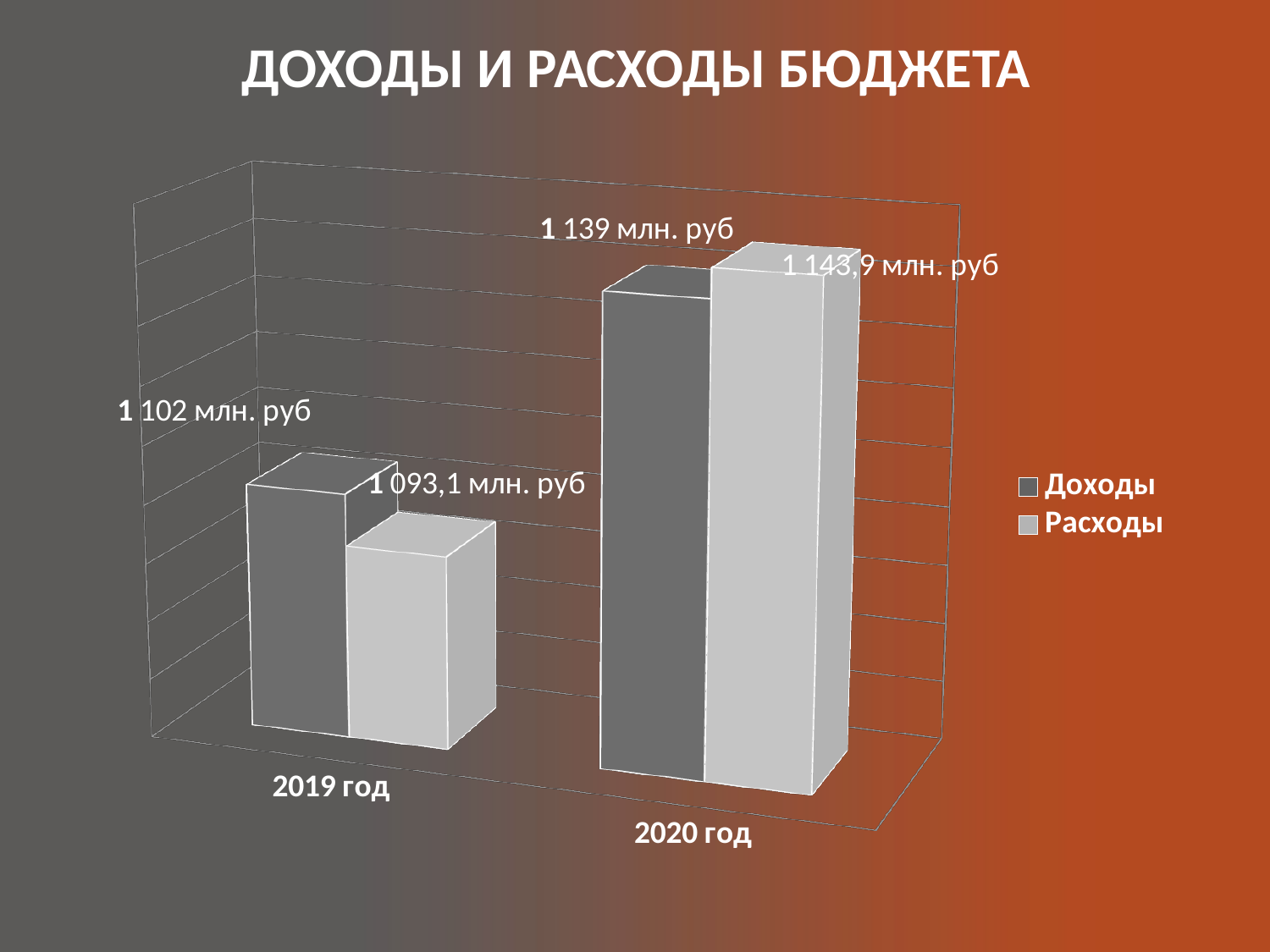
How many series does the legend list? 2 Which bar has the highest value on the chart? Расходы, 2020 год In 2020 год, which is larger: Доходы or Расходы? Расходы What kind of chart is shown on the slide? Bar chart What is the title of the chart? ДОХОДЫ И РАСХОДЫ БЮДЖЕТА What is the value of Доходы for 2019 год? 1 102 млн. руб What is the value of Расходы for 2019 год? 1 093,1 млн. руб What is the difference between Доходы and Расходы in 2019 год? 8,9 млн. руб What is the value of Доходы for 2020 год? 1 139 млн. руб By how much did Доходы increase from 2019 год to 2020 год? 37 млн. руб What is the value of Расходы for 2020 год? 1 143,9 млн. руб Which bar has the lowest value on the chart? Расходы, 2019 год